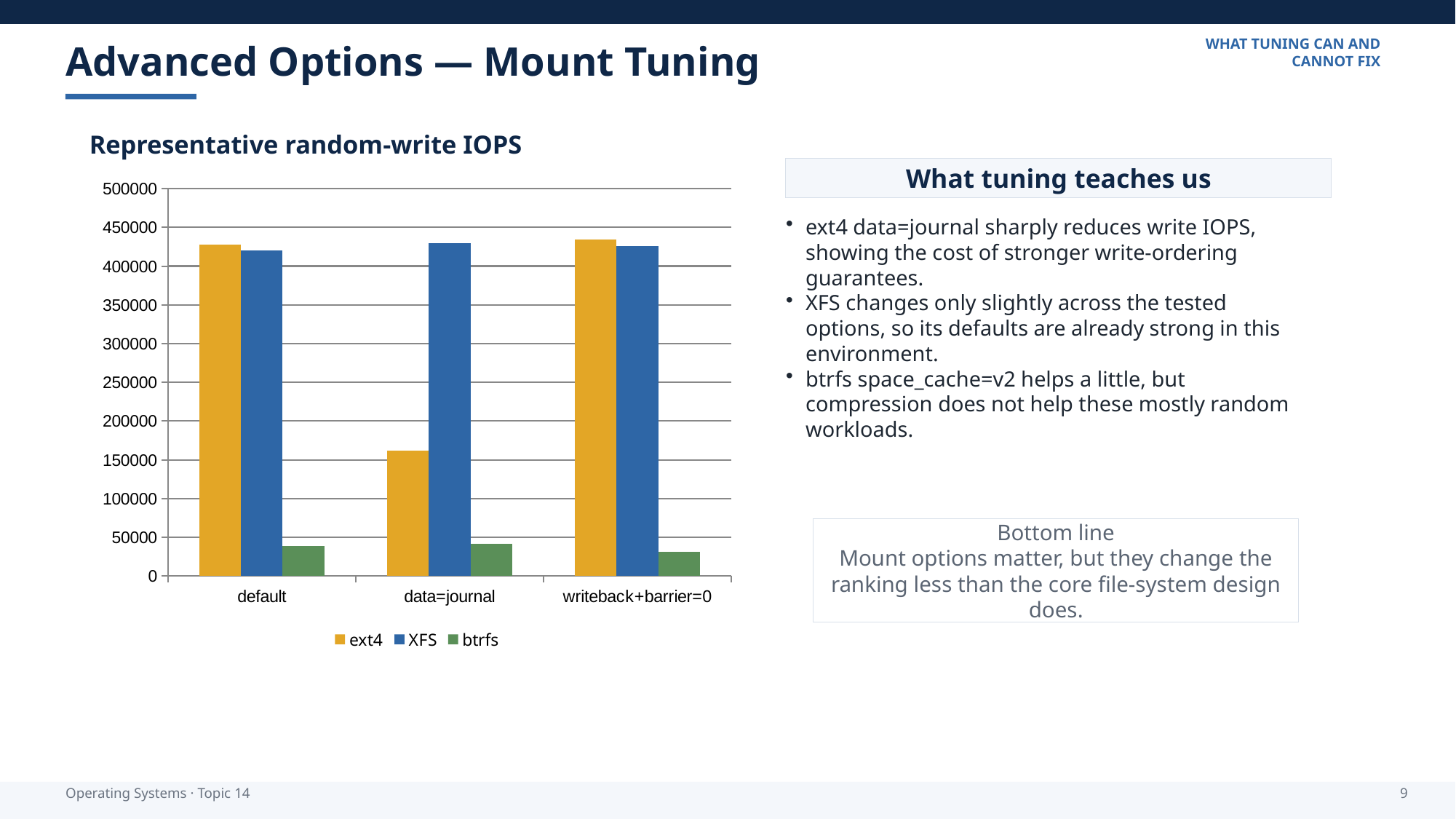
Which series has the lowest value for the default category? btrfs For which category is the ext4 value lowest? data=journal How many mount-option categories are shown on the x axis? 3 What is the title of the chart? Representative random-write IOPS Which colour represents XFS in the chart legend? blue Is the btrfs value for default greater or less than 50000? less Is the ext4 value for data=journal greater or less than 200000? less Is the XFS value for data=journal greater or less than 400000? greater What kind of chart is shown on the slide? bar chart Which series has the highest value for the data=journal category? XFS For data=journal, which is larger: the ext4 value or the XFS value? XFS How many series does the chart legend list? 3